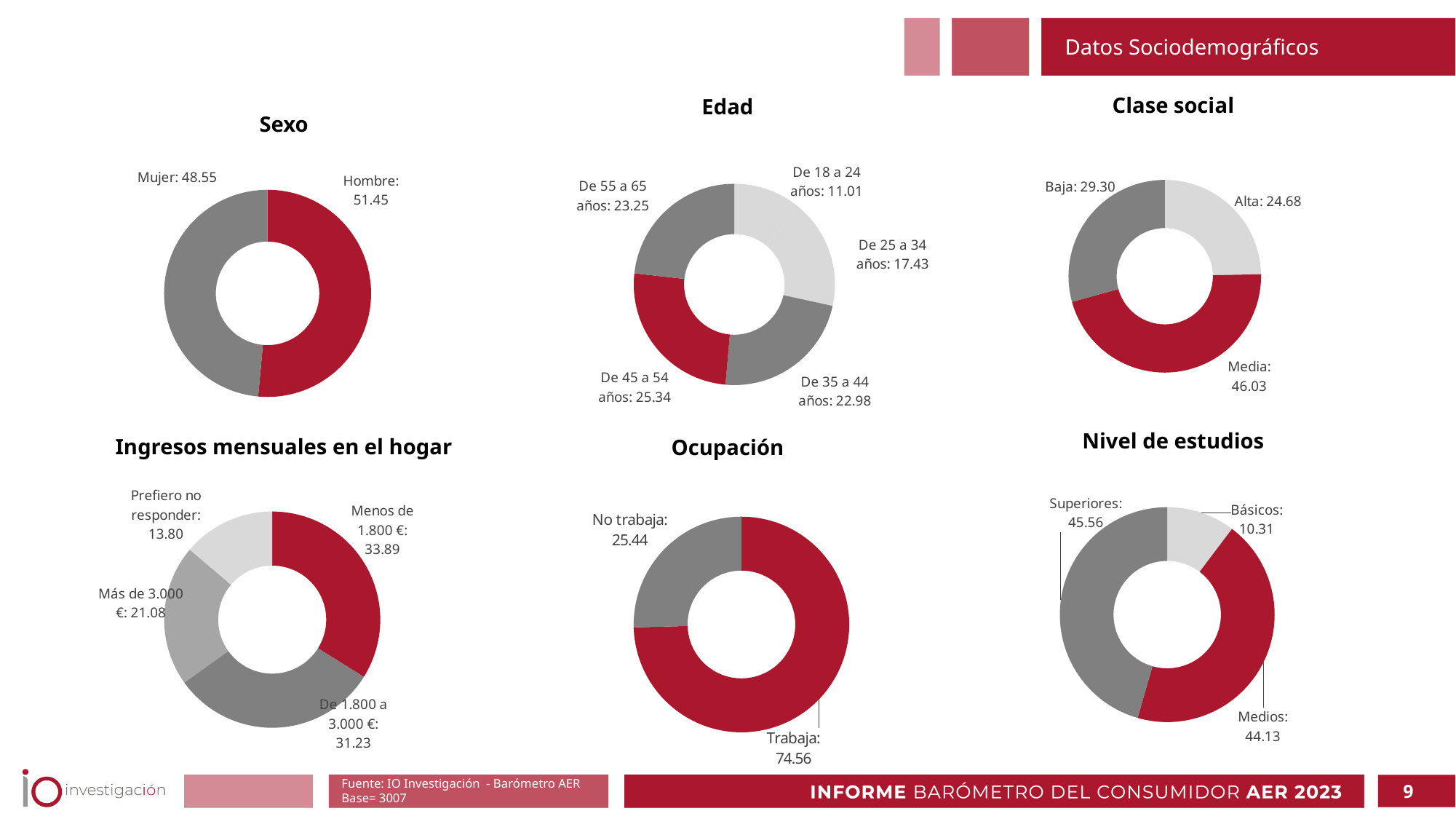
In the 'Nivel de estudios' chart, which is larger, Superiores or Medios? Superiores What type of chart is used for 'Ocupación'? Doughnut chart In the 'Edad' chart, which age group has the largest share? De 45 a 54 años How many charts are shown on the slide? 6 In the 'Clase social' chart, what is the difference between Baja and Alta? 4.62 In the 'Ingresos mensuales en el hogar' chart, which category is the largest? Menos de 1.800 € In the 'Sexo' chart, what is the value for Hombre? 51.45 In the 'Edad' chart, which age group has the smallest share? De 18 a 24 años In the 'Ocupación' chart, what is the difference between Trabaja and No trabaja? 49.12 In the 'Edad' chart, how many age categories are shown? 5 In the 'Clase social' chart, what is the value for Media? 46.03 In the 'Ingresos mensuales en el hogar' chart, what is the value for 'Prefiero no responder'? 13.80